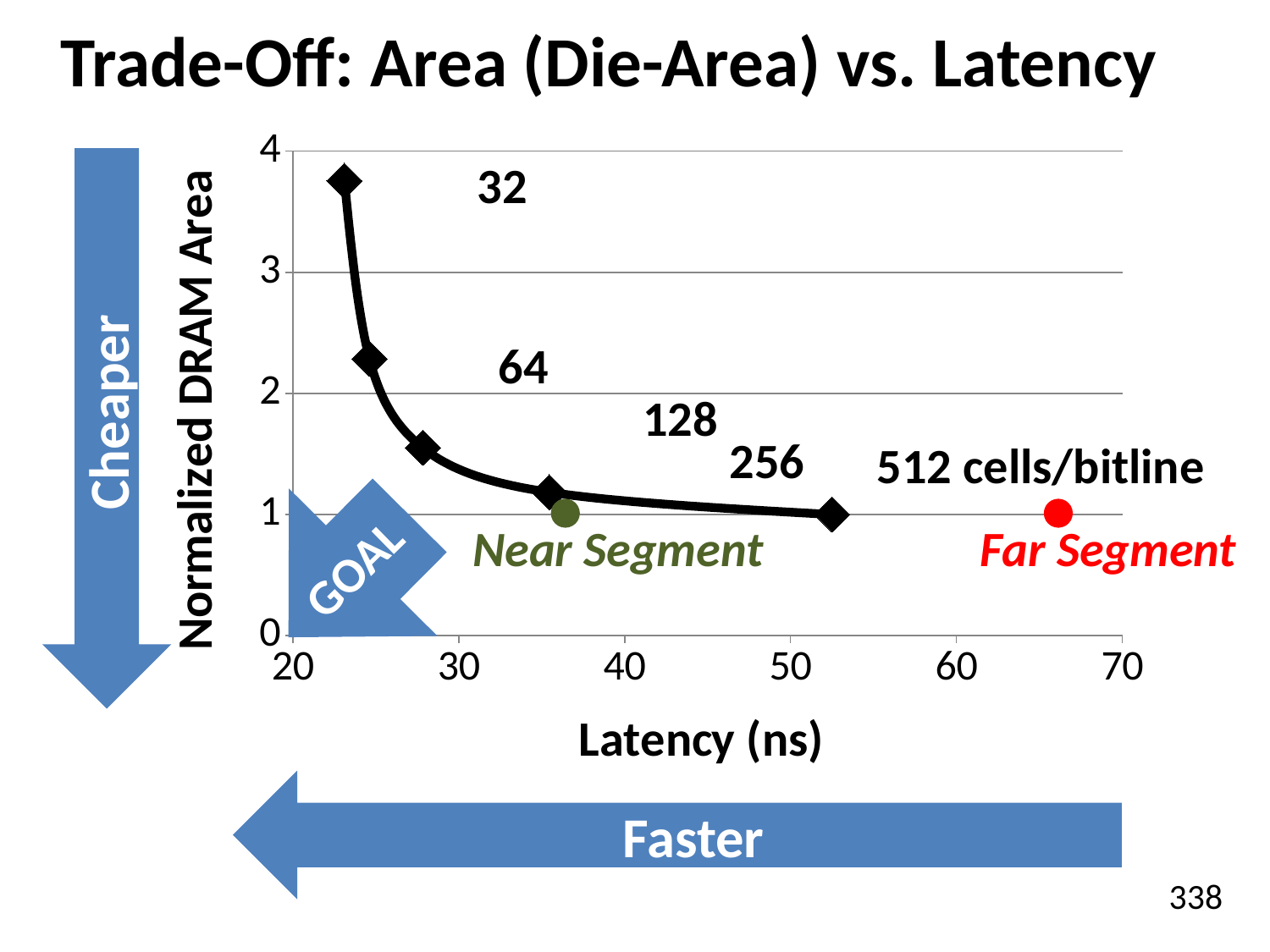
As latency increases along the x axis, does the normalized DRAM area rise or fall? fall Which cells/bitline configuration has the lowest normalized DRAM area? 512 Is the latency of the Near Segment point greater or less than 40 ns? less What is the title of the chart's y axis? Normalized DRAM Area What is the normalized DRAM area for 512 cells/bitline? 1 What kind of chart is shown on the slide? line chart with markers (scatter) Which cells/bitline configuration has the highest normalized DRAM area? 32 Is the normalized DRAM area for 64 cells/bitline greater or less than 2? greater Is the latency of the Far Segment point greater or less than 60 ns? greater What is the title of the chart's x axis? Latency (ns) How many diamond data points are plotted on the black curve? 5